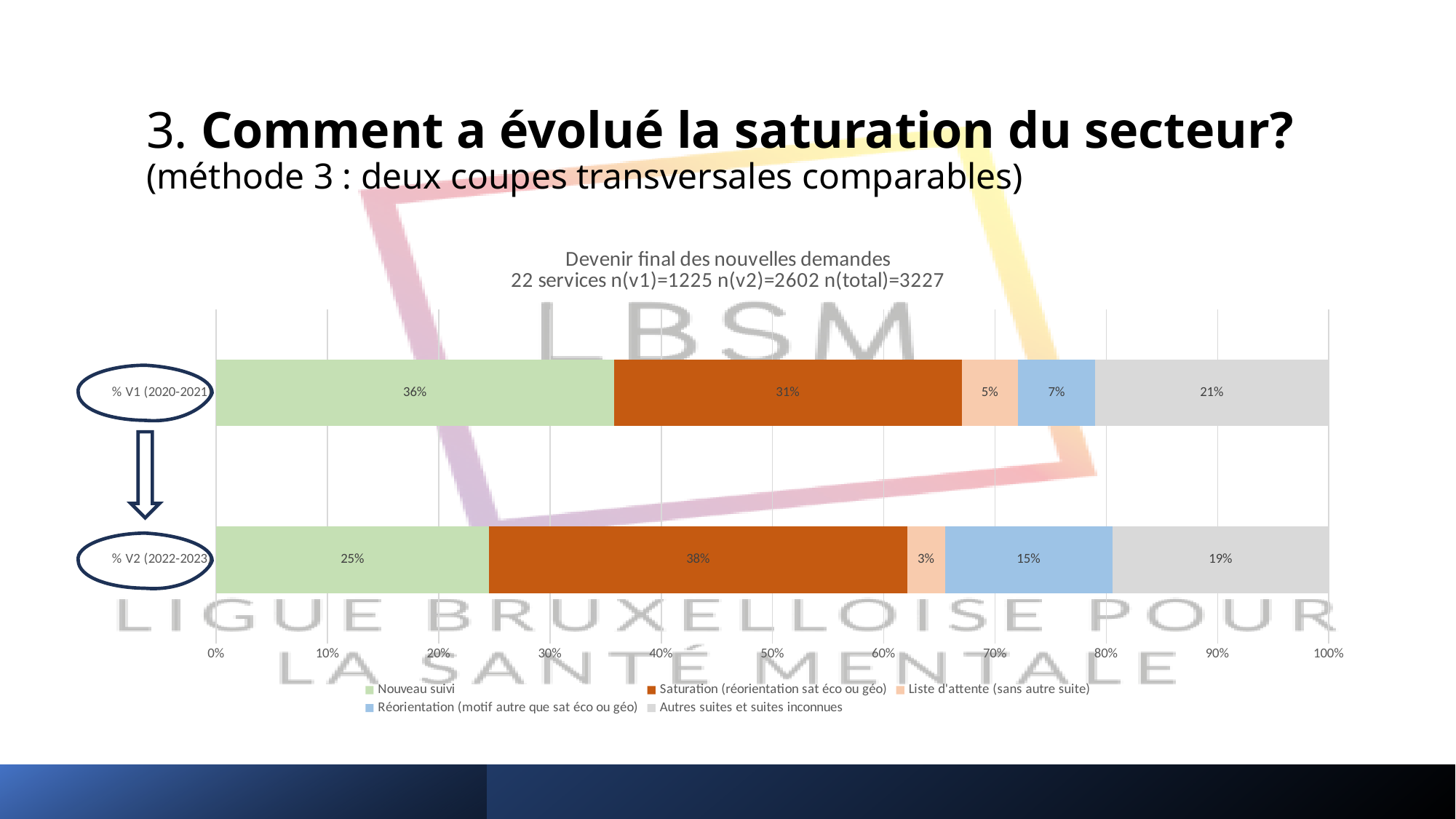
What is the value of Nouveau suivi for % V1 (2020-2021)? 36% What is the title of the chart? Devenir final des nouvelles demandes 22 services n(v1)=1225 n(v2)=2602 n(total)=3227 What is the difference between the Saturation values for % V2 (2022-2023) and % V1 (2020-2021)? 7% What is the value of Réorientation (motif autre que sat éco ou géo) for % V1 (2020-2021)? 7% Which segment is the smallest in the % V1 (2020-2021) bar? Liste d'attente (sans autre suite) What is the value of Saturation (réorientation sat éco ou géo) for % V2 (2022-2023)? 38% How many categories (bars) are plotted in the chart? 2 What type of chart is shown on the slide? Stacked bar chart How many series does the legend list? 5 What is the value of Liste d'attente (sans autre suite) for % V2 (2022-2023)? 3% Which is larger: Nouveau suivi for % V1 (2020-2021) or Nouveau suivi for % V2 (2022-2023)? % V1 (2020-2021) Which segment is the largest in the % V2 (2022-2023) bar? Saturation (réorientation sat éco ou géo)